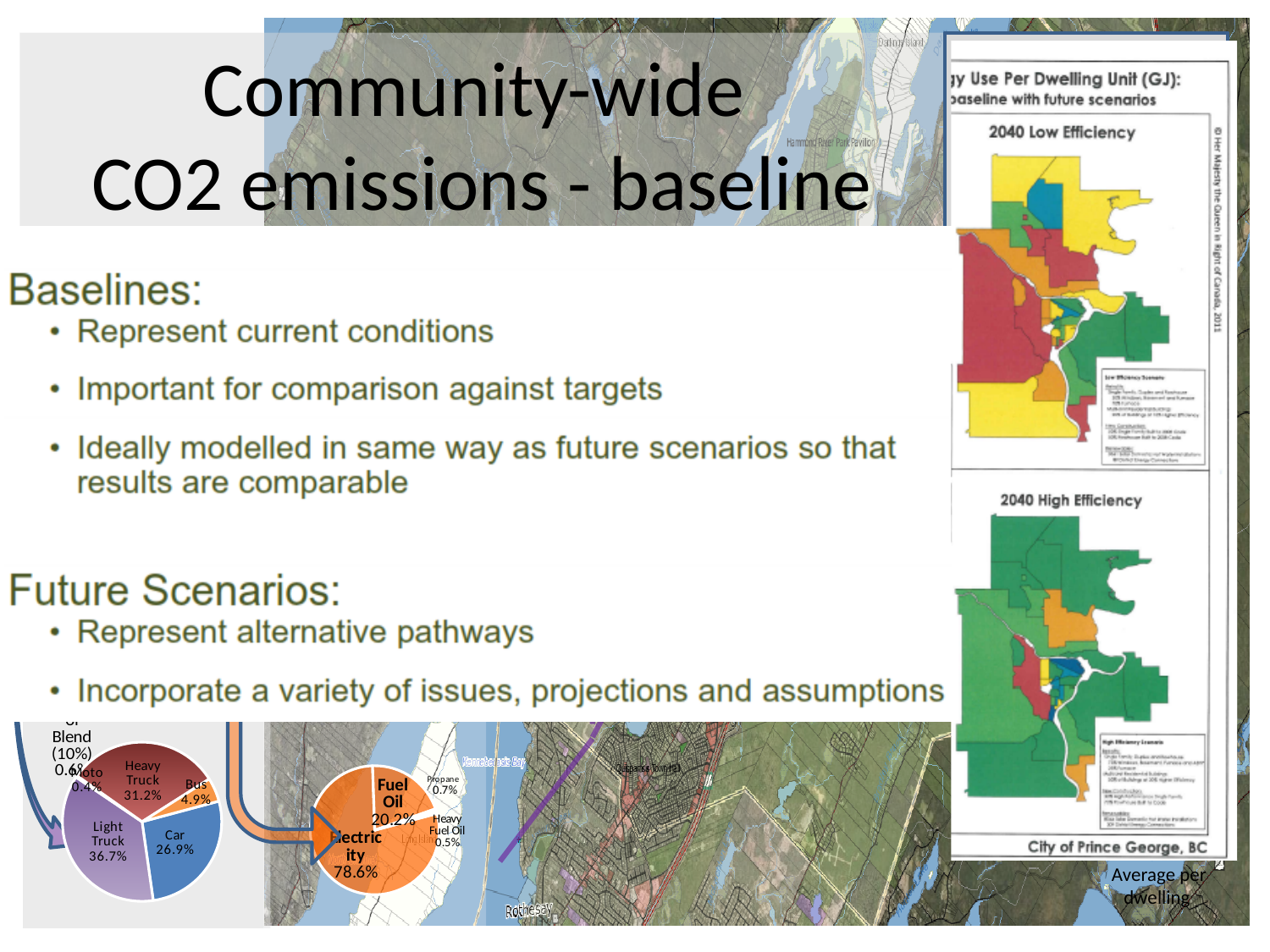
In the bottom-left pie chart, what share is labelled for Bus? 4.9% In the bottom-left pie chart, what share is labelled for Light Truck? 36.7% In the bottom-centre pie chart, what share is labelled for Fuel Oil? 20.2% In the bottom-centre pie chart, what share is labelled for Electricity? 78.6% In the bottom-left pie chart, what share is labelled for Car? 26.9% In the bottom-left pie chart, which labelled category has the largest share? Light Truck In the bottom-centre pie chart, what share is labelled for Propane? 0.7% In the bottom-left pie chart, what share is labelled for Heavy Truck? 31.2% In the bottom-left pie chart, what is the difference between the Light Truck and Car shares? 9.8% In the bottom-left pie chart, which is larger, Heavy Truck or Car? Heavy Truck In the bottom-centre pie chart, which category has the smallest share? Heavy Fuel Oil What type of chart is the bottom-centre chart showing Electricity and Fuel Oil? Pie chart